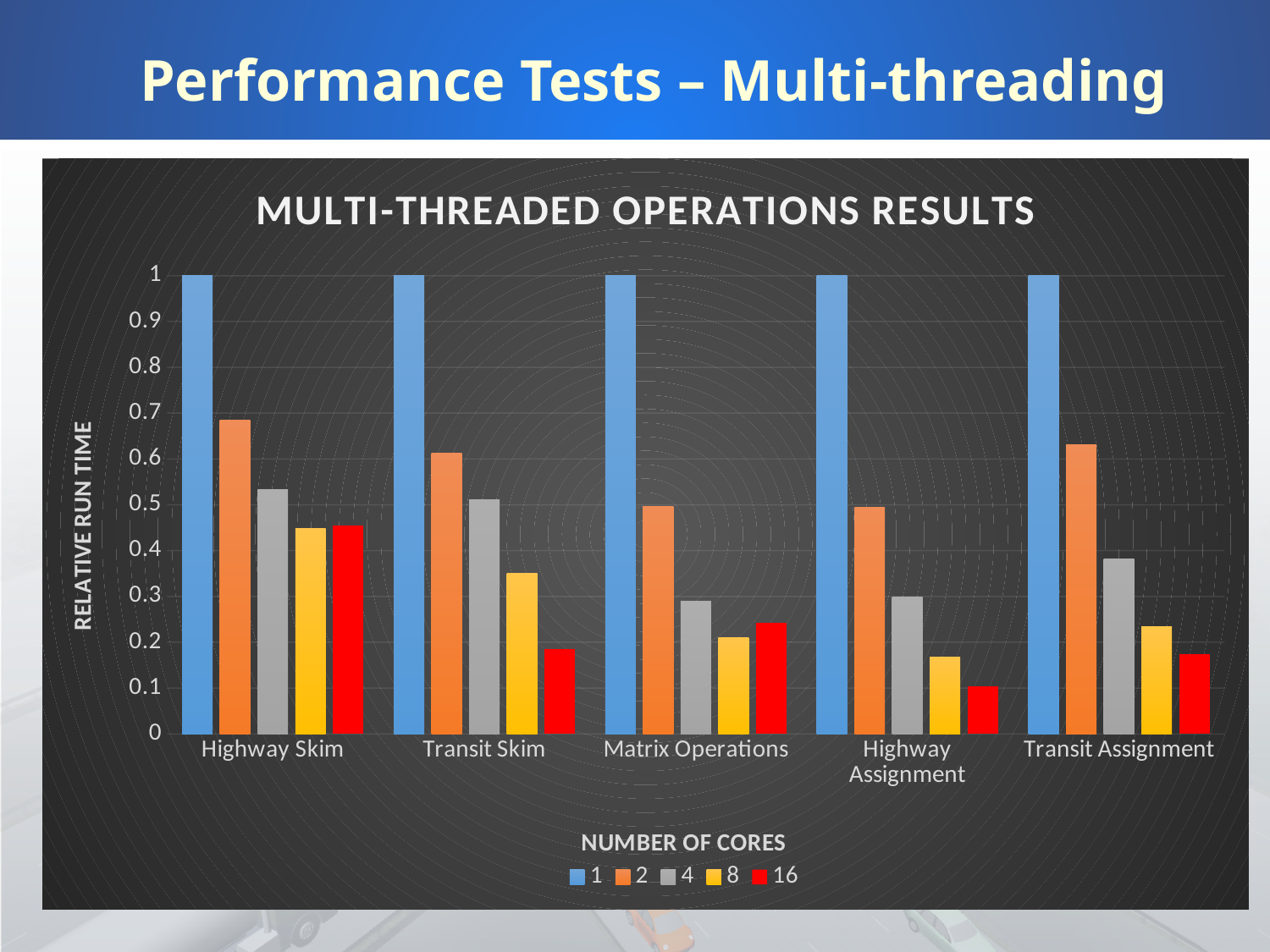
What is the title of the chart? MULTI-THREADED OPERATIONS RESULTS Is the value for Transit Skim with 16 cores greater or less than 0.2? less How many series does the legend list? 5 Which operation has the lowest relative run time with 16 cores? Highway Assignment Is the value for Highway Assignment with 16 cores greater or less than 0.2? less What is the label of the y axis? RELATIVE RUN TIME For Transit Skim, does the relative run time rise or fall as the number of cores increases from 1 to 16? fall Is the value for Highway Skim with 2 cores greater or less than 0.6? greater What type of chart is shown on the slide? bar chart How many operation categories are shown on the x axis? 5 Which is larger: the 8-core value for Transit Skim or the 8-core value for Matrix Operations? Transit Skim What is the relative run time for Matrix Operations with 1 core? 1